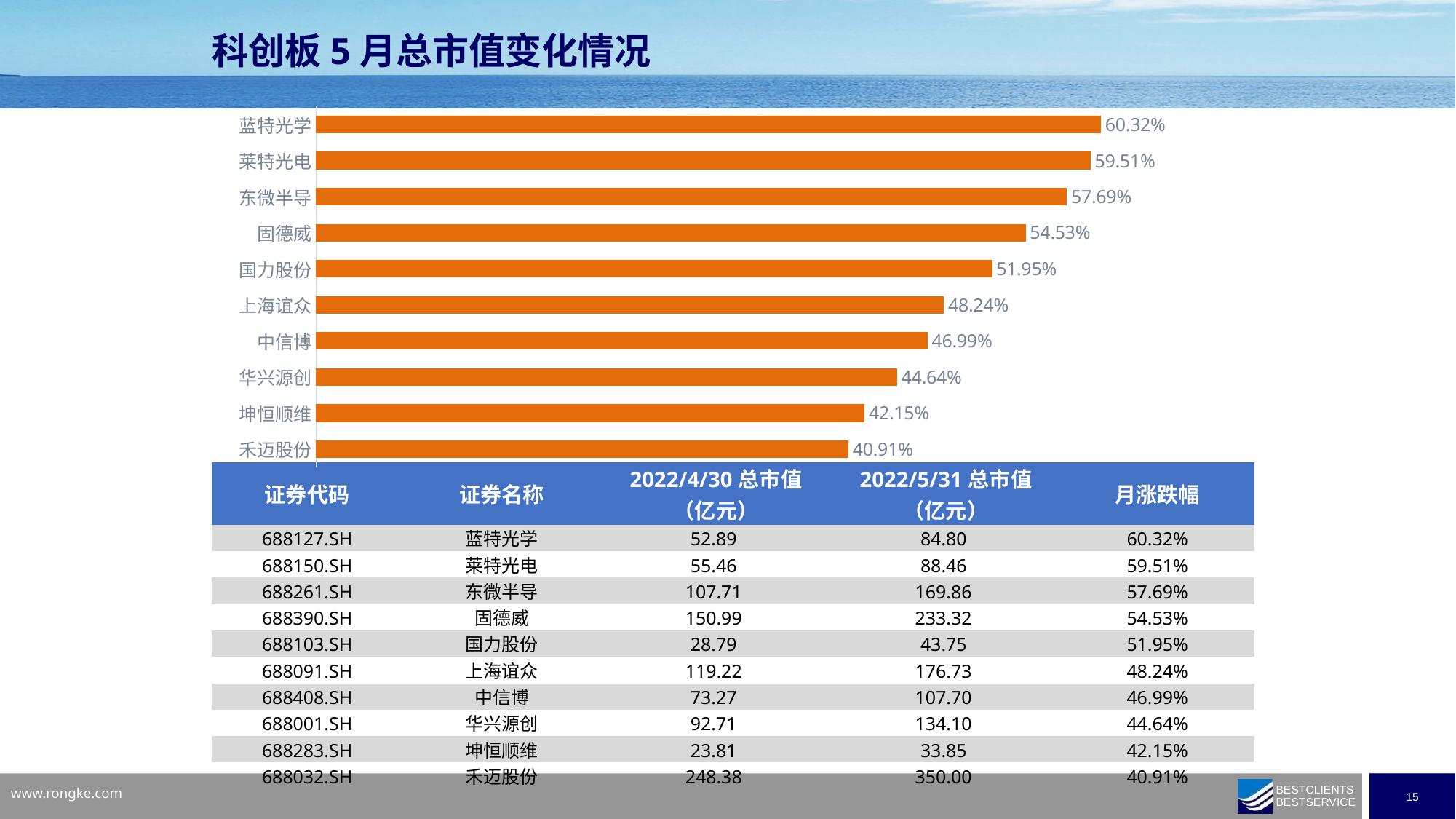
What is the value shown for 禾迈股份 in the bar chart? 40.91% What is the value shown for 国力股份 in the bar chart? 51.95% Which has a larger value in the bar chart, 东微半导 or 上海谊众? 东微半导 What is the difference between the values for 蓝特光学 and 禾迈股份 in the bar chart? 19.41% Which category has the lowest value in the bar chart? 禾迈股份 What is the title of the slide containing the bar chart? 科创板 5 月总市值变化情况 What is the value shown for 蓝特光学 in the bar chart? 60.32% Do the values in the bar chart increase or decrease from the top category to the bottom category? Decrease How many categories are shown in the bar chart? 10 What kind of chart is shown on the slide? Bar chart Which category has the highest value in the bar chart? 蓝特光学 What is the difference between the values for 固德威 and 中信博 in the bar chart? 7.54%